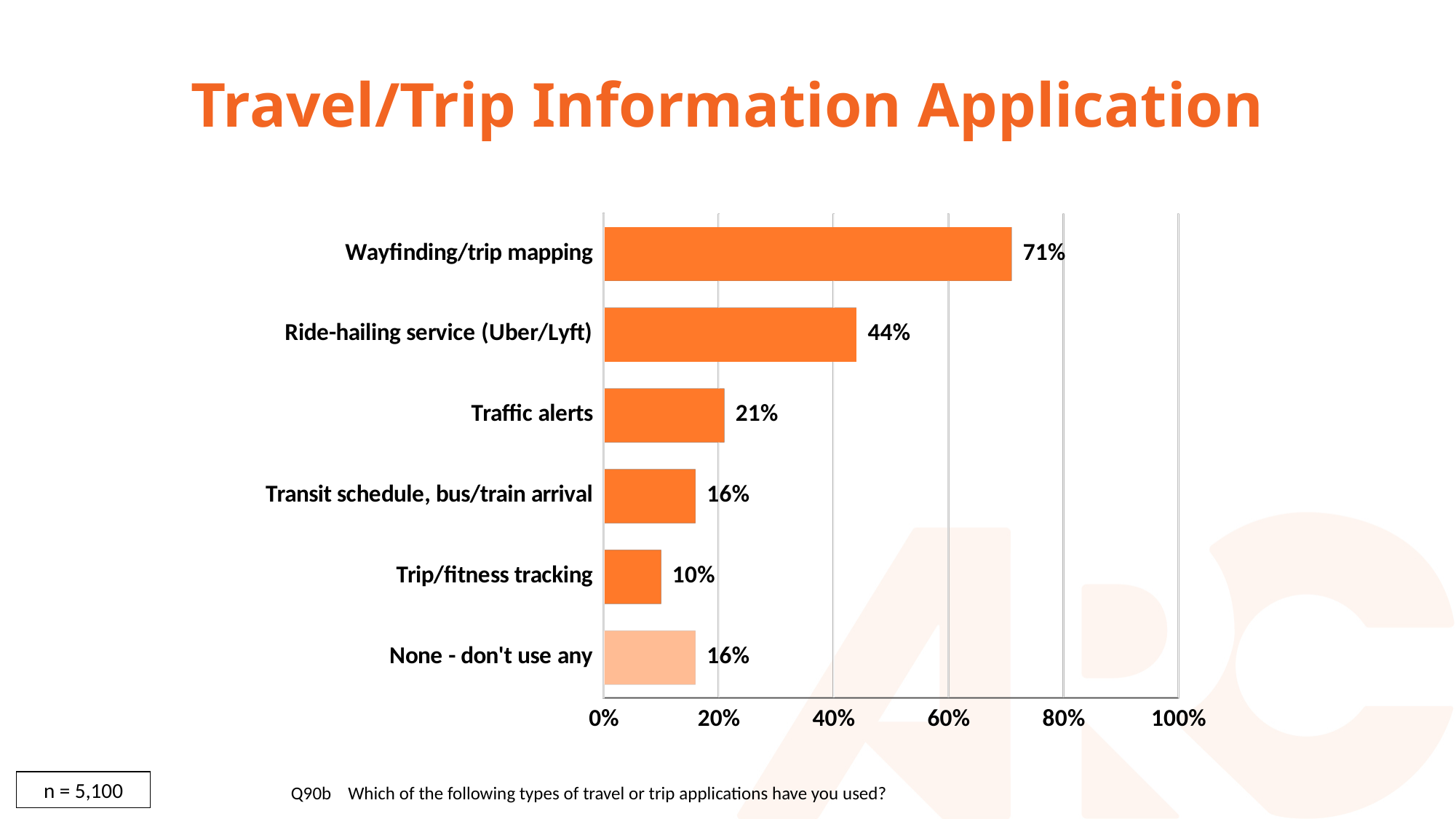
What percentage of respondents use Wayfinding/trip mapping applications? 71% What is the value for Ride-hailing service (Uber/Lyft)? 44% What kind of chart is shown on the slide? bar chart What is the value for Trip/fitness tracking? 10% Which category has the highest value? Wayfinding/trip mapping What is the sample size shown on the slide? n = 5,100 Is the value for Ride-hailing service (Uber/Lyft) greater or less than 40%? greater What percentage is shown for Traffic alerts? 21% Which category has the lowest value? Trip/fitness tracking What is the difference between Wayfinding/trip mapping and Ride-hailing service (Uber/Lyft)? 27% How many categories are shown in the chart? 6 Which is larger, Traffic alerts or Transit schedule, bus/train arrival? Traffic alerts